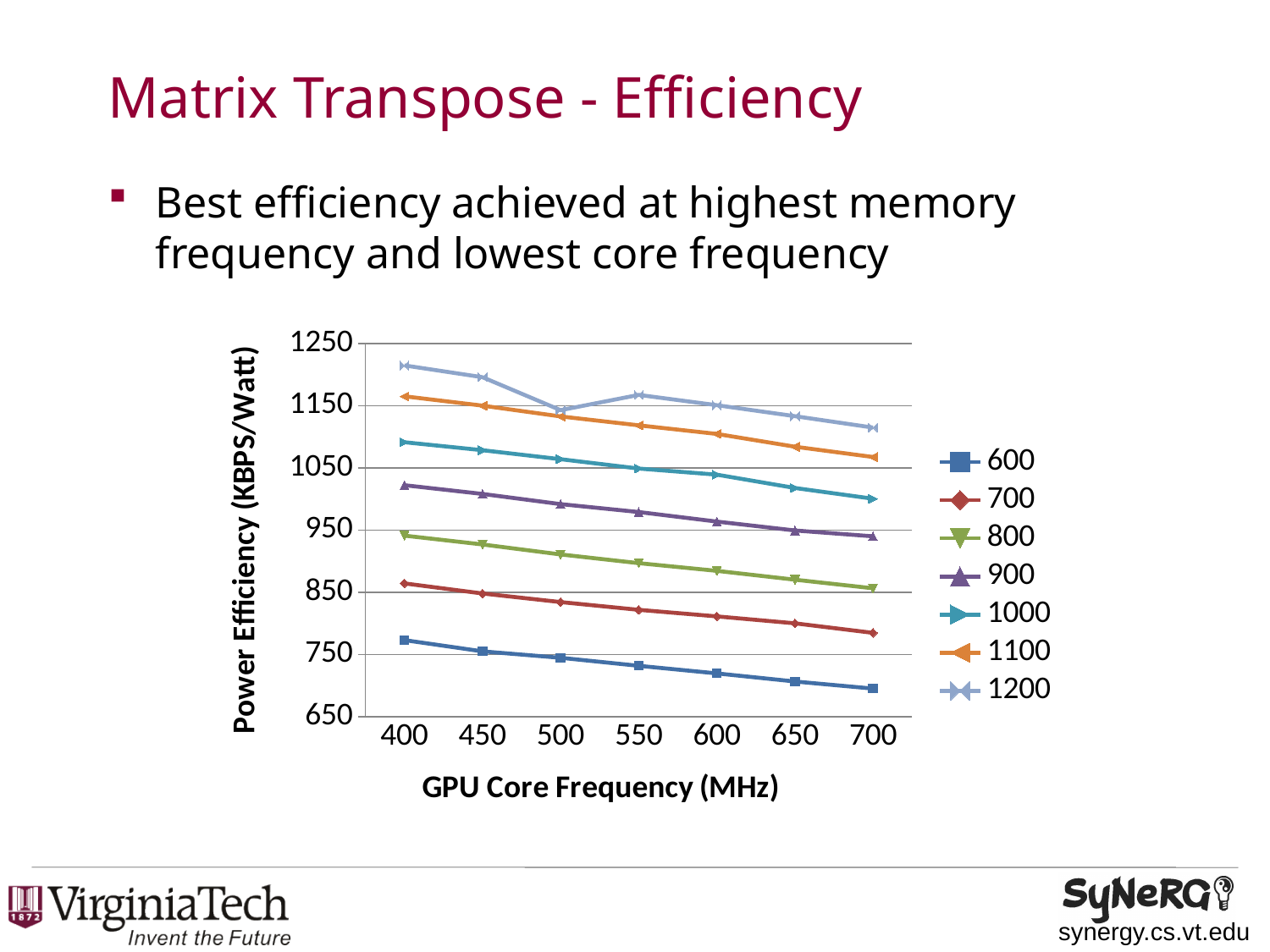
Is the value for the 600 series at 700 MHz greater or less than 750? less Do the values for the 600 series rise or fall as GPU core frequency increases from 400 to 700 MHz? fall Which series has the lowest power efficiency across the chart? 600 How many GPU core frequency points are plotted along the x axis? 7 Is the value for the 600 series at 400 MHz greater or less than 750? greater How many series does the legend list? 7 What is the label of the y axis? Power Efficiency (KBPS/Watt) What kind of chart is shown on the slide? line chart Is the value for the 1000 series at 700 MHz greater or less than 1050? less At 400 MHz, which series has the larger value, 1200 or 600? 1200 Which series has the highest power efficiency across the chart? 1200